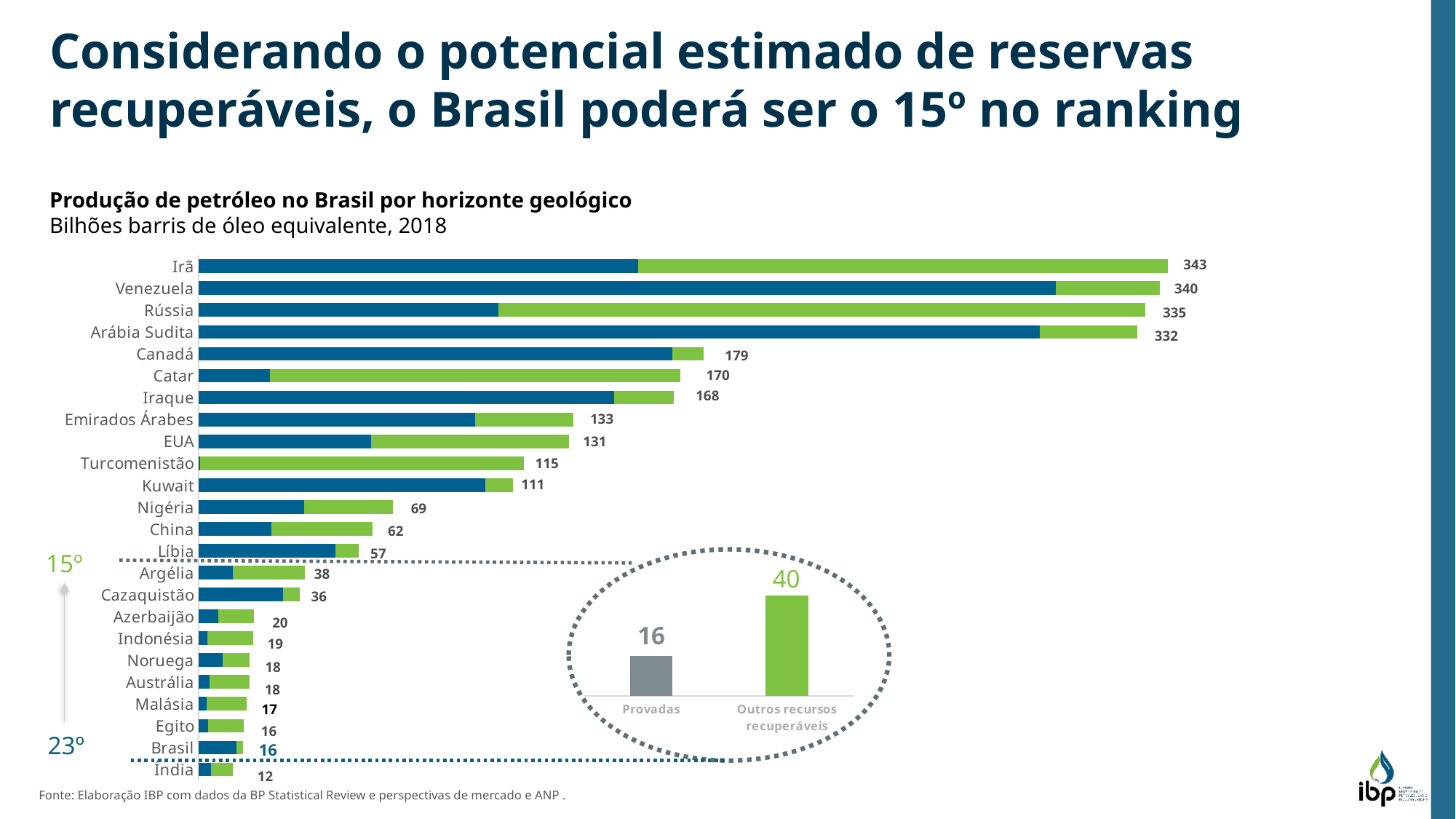
In the main bar chart, what is the value shown for Canadá? 179 In the main bar chart, what is the value shown for Brasil? 16 What kind of chart is the main chart on the slide? Bar chart In the inset chart inside the circle, what is the value for Outros recursos recuperáveis? 40 In the inset chart inside the circle, what is the difference between Outros recursos recuperáveis and Provadas? 24 How many countries are shown in the main bar chart? 24 In the main bar chart, what is the difference between the values for Irã and Venezuela? 3 In the main bar chart, which country has the highest value? Irã In the inset chart inside the circle, what is the value for Provadas? 16 In the main bar chart, which has a larger value, Catar or Iraque? Catar In the main bar chart, what is the value shown for Irã? 343 In the main bar chart, which country has the lowest value? Índia